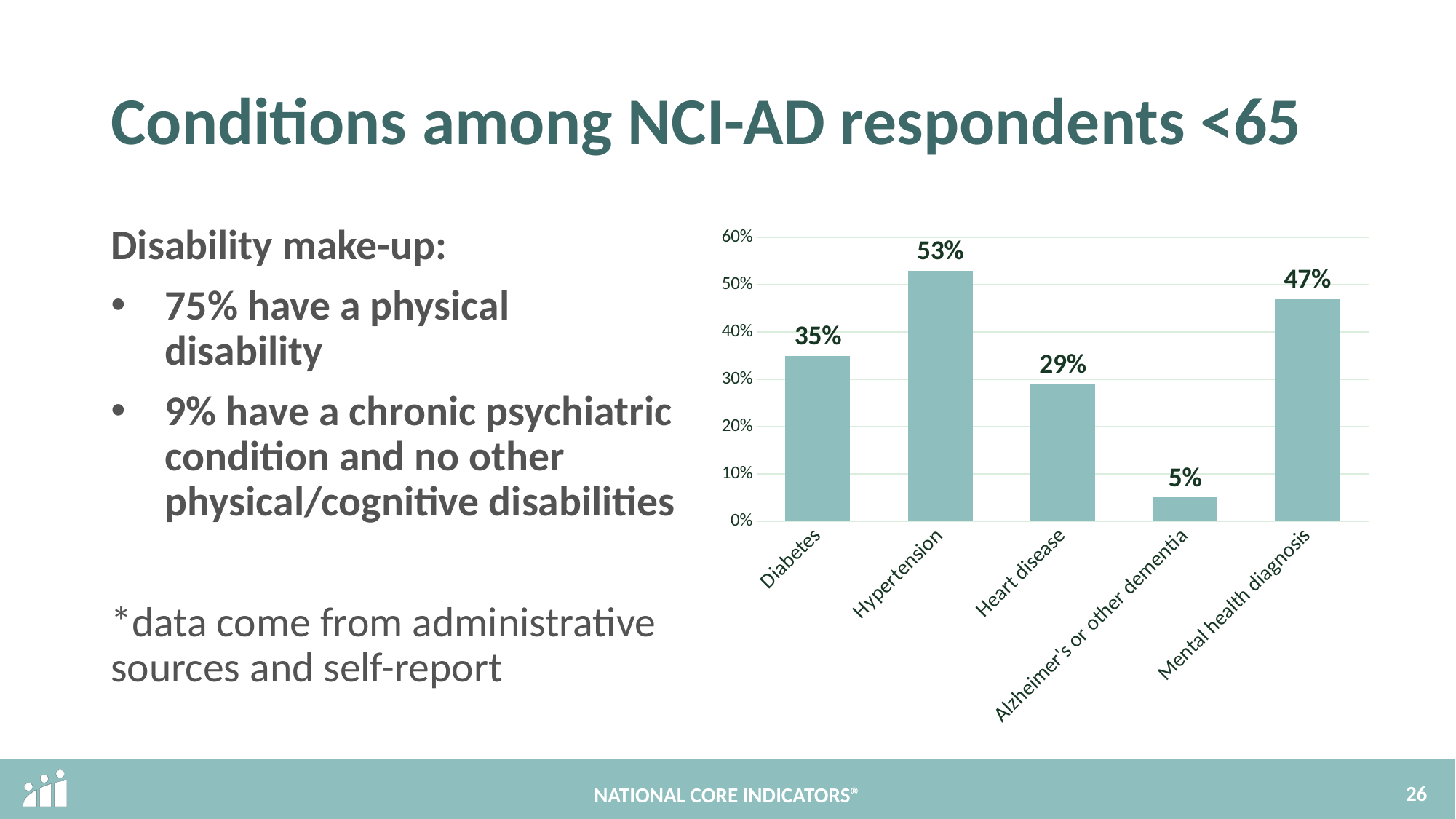
Which condition has the highest value? Hypertension What is the difference between the values for Mental health diagnosis and Heart disease? 18% What is the value for Mental health diagnosis? 47% What is the value for Hypertension? 53% Is the value for Mental health diagnosis greater or less than 40%? greater What kind of chart is shown on the slide? bar chart What is the difference between the values for Hypertension and Diabetes? 18% Which condition has the lowest value? Alzheimer's or other dementia How many conditions are shown on the chart? 5 What is the highest value shown on the chart's vertical axis? 60% Which is larger, the value for Diabetes or the value for Heart disease? Diabetes What is the value for Alzheimer's or other dementia? 5%